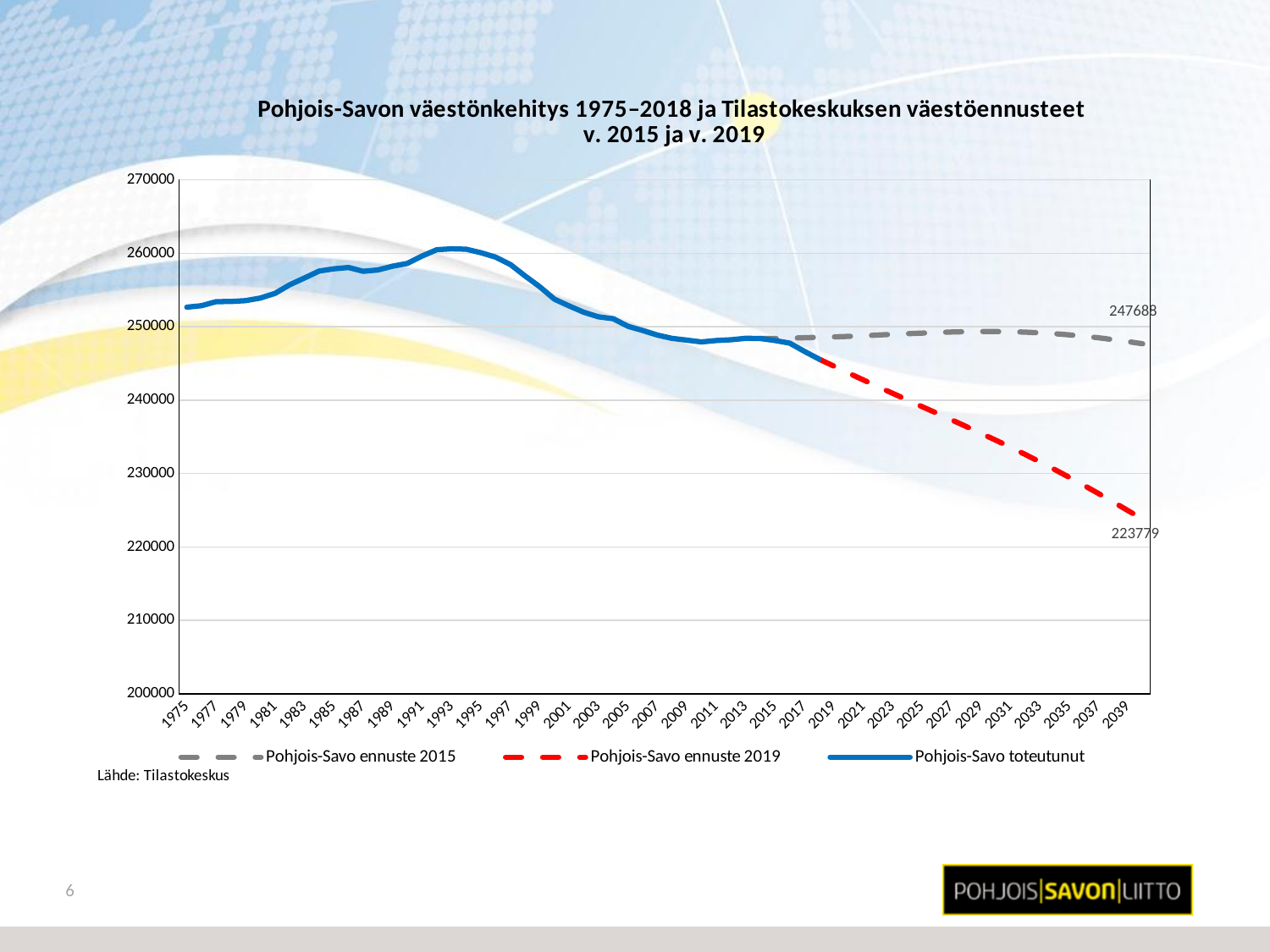
Is the value of Pohjois-Savo ennuste 2019 in 2039 greater or less than 230000? less What is the difference between the labelled end values of the 2015 forecast (247688) and the 2019 forecast (223779)? 23909 How many series does the legend list? 3 Which forecast series ends at a higher value, Pohjois-Savo ennuste 2015 or Pohjois-Savo ennuste 2019? Pohjois-Savo ennuste 2015 Does the Pohjois-Savo toteutunut series rise or fall between 1993 and 2017? fall What is the title of the chart? Pohjois-Savon väestönkehitys 1975–2018 ja Tilastokeskuksen väestöennusteet v. 2015 ja v. 2019 Is the value of Pohjois-Savo toteutunut in 1975 greater or less than 250000? greater What is the labelled end value of the Pohjois-Savo ennuste 2015 series? 247688 Is the value of Pohjois-Savo toteutunut in 2017 greater or less than 250000? less What kind of chart is shown on the slide? line chart What source is cited below the chart? Tilastokeskus What is the labelled end value of the Pohjois-Savo ennuste 2019 series? 223779